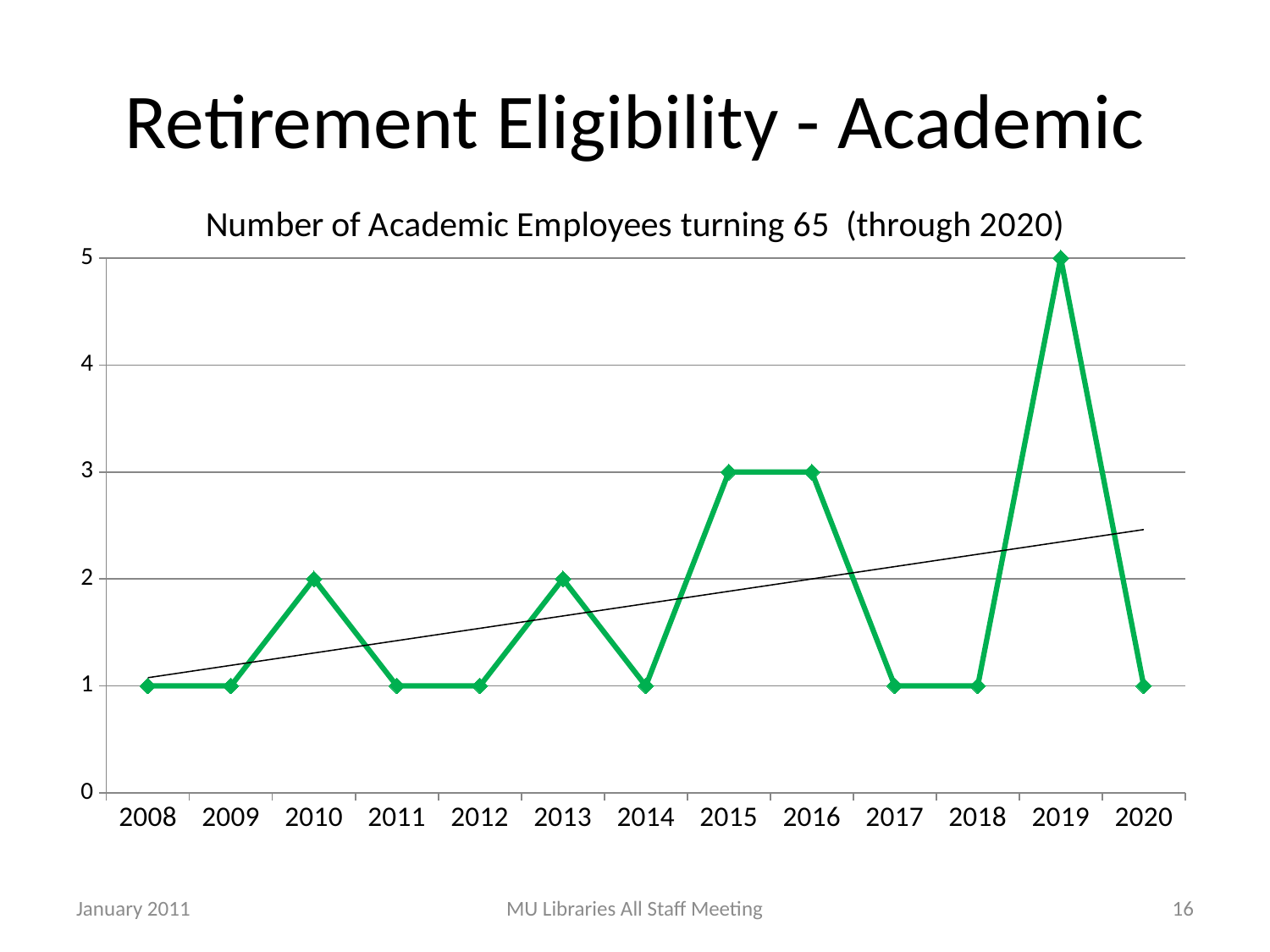
Which is larger, the value for 2013 or the value for 2017? 2013 What is the value for 2010? 2 What is the difference between the values for 2015 and 2014? 2 What is the number of academic employees turning 65 in 2019? 5 What kind of chart is shown on the slide? line chart How many years are shown on the x axis? 13 Is the value for 2019 greater or less than 4? greater What is the title of the chart? Number of Academic Employees turning 65 (through 2020) What is the value for 2015? 3 What is the value for 2020? 1 What is the difference between the values for 2019 and 2016? 2 Which year has the highest number of academic employees turning 65? 2019